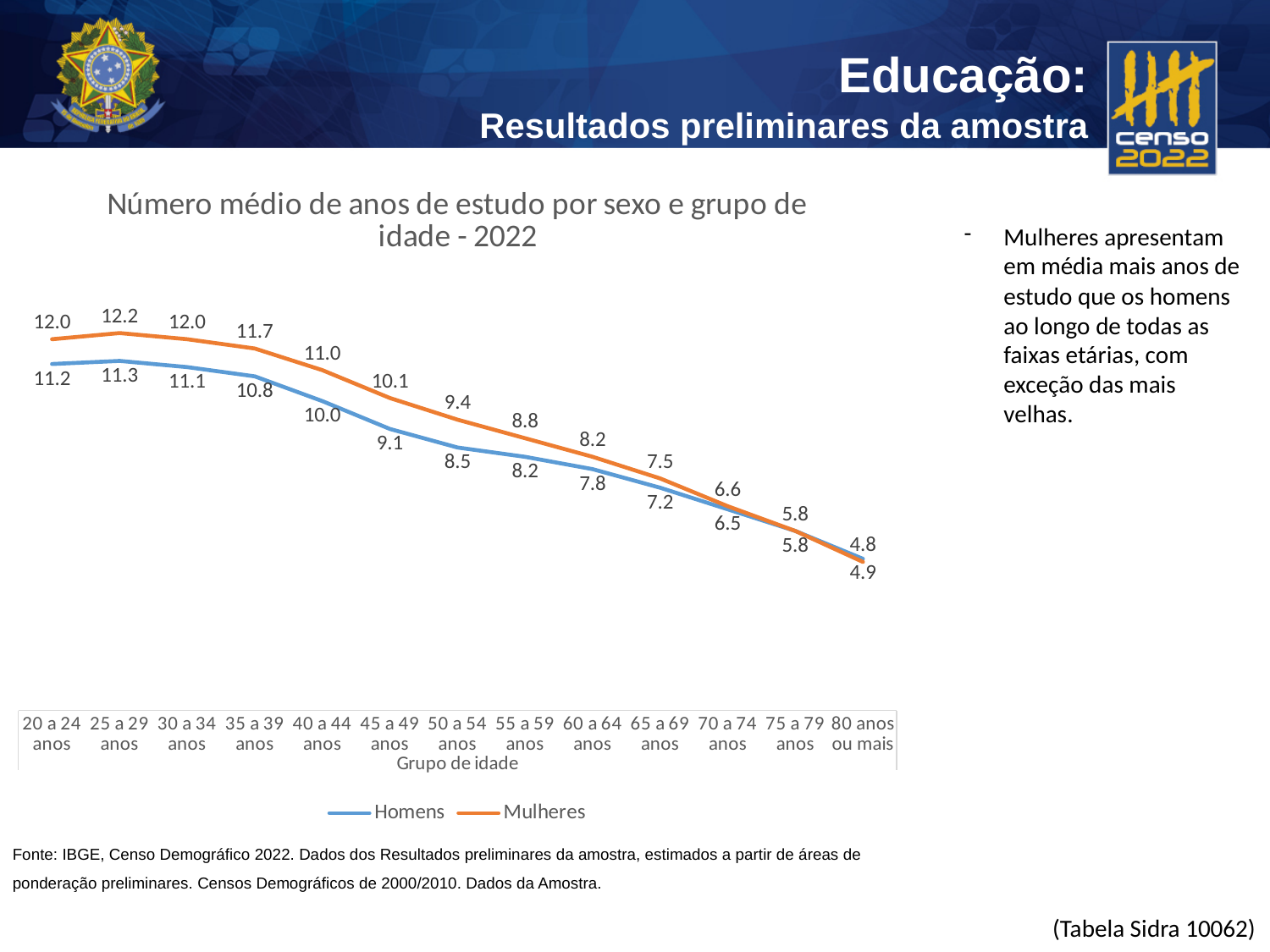
Which age group has the highest value for Mulheres? 25 a 29 anos What is the value for Mulheres in the 25 a 29 anos group? 12.2 How many series does the legend list? 2 What is the value for Homens in the 80 anos ou mais group? 4.9 In the 80 anos ou mais group, which series has the larger value, Homens or Mulheres? Homens What is the difference between Mulheres and Homens in the 45 a 49 anos group? 1.0 Do the values for Mulheres rise or fall from the 30 a 34 anos group to the 80 anos ou mais group? fall What type of chart is shown on the slide? line chart Which age group has the lowest value for Homens? 80 anos ou mais How many age groups are plotted on the x axis? 13 What is the value for Homens in the 40 a 44 anos group? 10.0 What is the title of the chart? Número médio de anos de estudo por sexo e grupo de idade - 2022